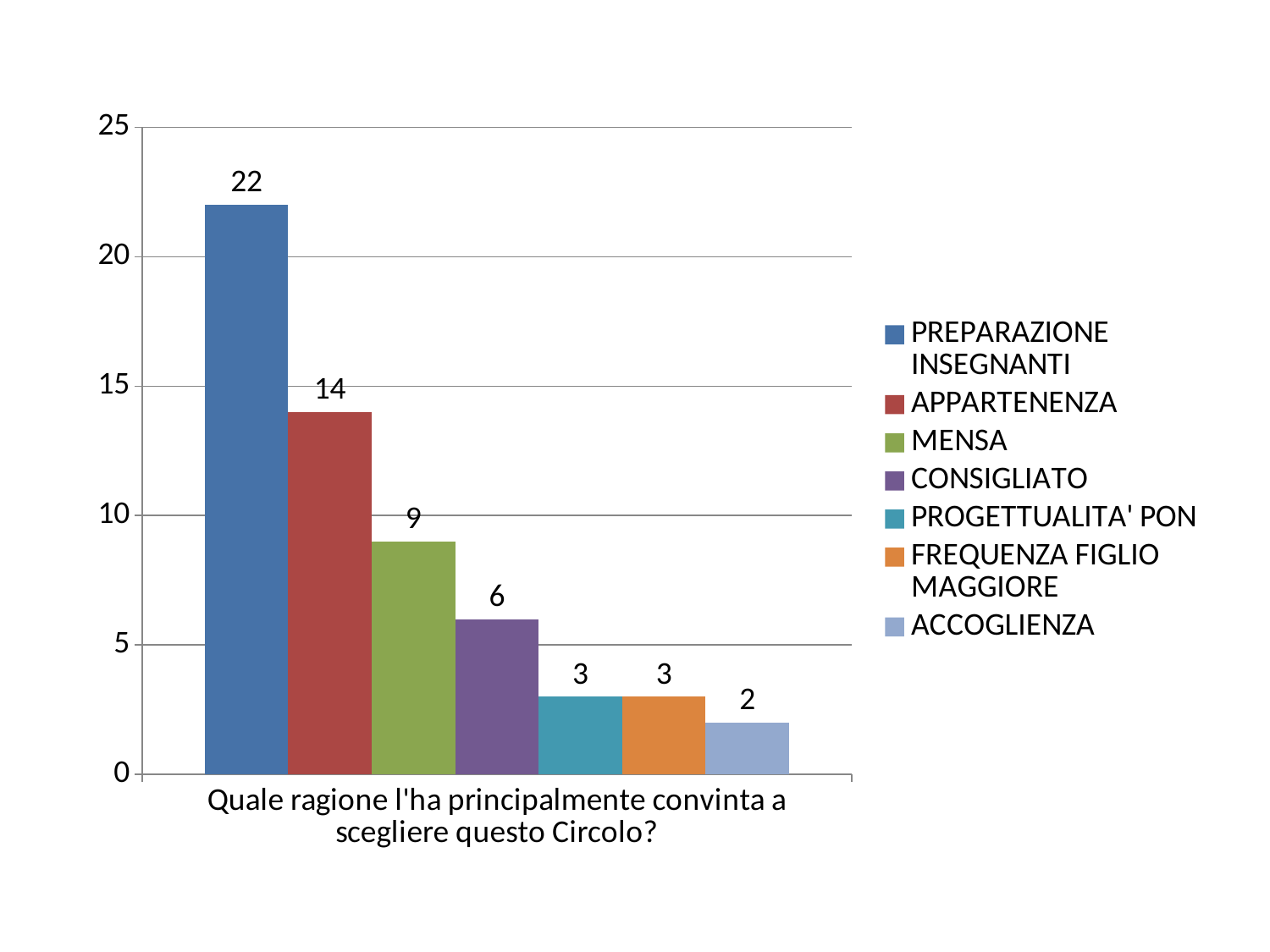
Which is larger, the value for MENSA or the value for CONSIGLIATO? MENSA Is the value for APPARTENENZA greater or less than 10? greater What is the value for ACCOGLIENZA? 2 What is the value for MENSA? 9 What kind of chart is shown on the slide? bar chart What is the value for APPARTENENZA? 14 Which series has the lowest value? ACCOGLIENZA What is the difference between the values for PREPARAZIONE INSEGNANTI and APPARTENENZA? 8 What is the value for PREPARAZIONE INSEGNANTI? 22 What is the x-axis category label shown below the bars? Quale ragione l'ha principalmente convinta a scegliere questo Circolo? Which series has the highest value? PREPARAZIONE INSEGNANTI How many series does the legend list? 7